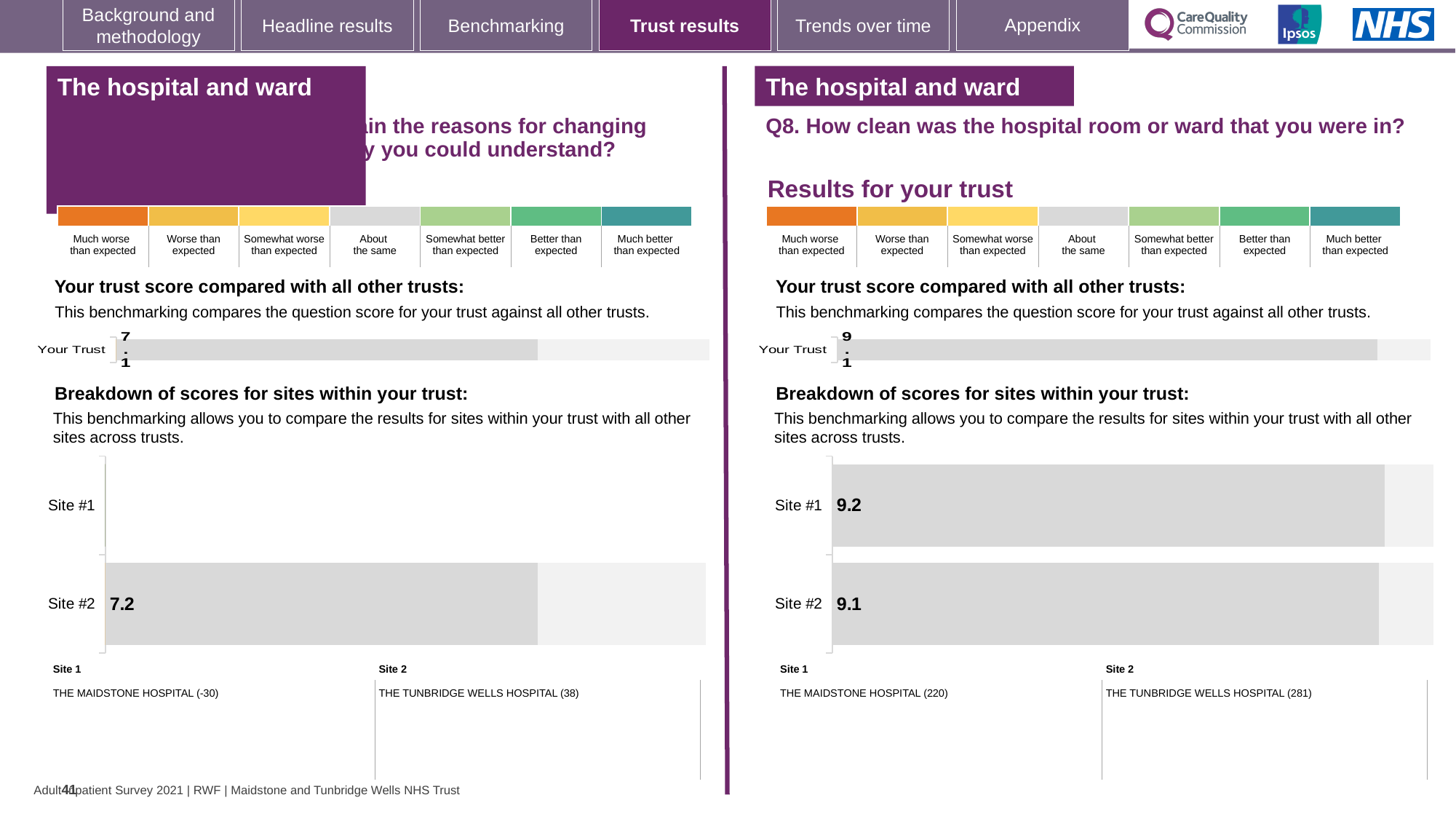
On the Q8 chart on the right half of the slide, what is the score shown for Site #1 in the breakdown of scores for sites within your trust? 9.2 On the Q8 site breakdown chart on the right half of the slide, what is the difference between the Site #1 score and the Site #2 score? 0.1 On the Q8 site breakdown chart on the right half of the slide, which site has the higher score, Site #1 or Site #2? Site #1 How many sites are shown in the Q8 site breakdown chart on the right half of the slide? 2 On the site breakdown chart on the left half of the slide, what is the difference between the Site #2 score and the 'Your Trust' score? 0.1 What type of chart is used to show the breakdown of scores for sites within your trust on the right half of the slide? Bar chart On the Q8 chart on the right half of the slide, what is the 'Your Trust' score compared with all other trusts? 9.1 On the site breakdown chart on the left half of the slide, what is the score shown for Site #2? 7.2 On the Q8 chart on the right half of the slide, what is the score shown for Site #2 in the breakdown of scores for sites within your trust? 9.1 On the right half of the slide, which hospital is listed as Site 1 below the Q8 site breakdown chart? THE MAIDSTONE HOSPITAL On the chart on the left half of the slide, what is the 'Your Trust' score compared with all other trusts? 7.1 On the right half of the slide, what number is shown in brackets after THE TUNBRIDGE WELLS HOSPITAL under Site 2 for Q8? 281